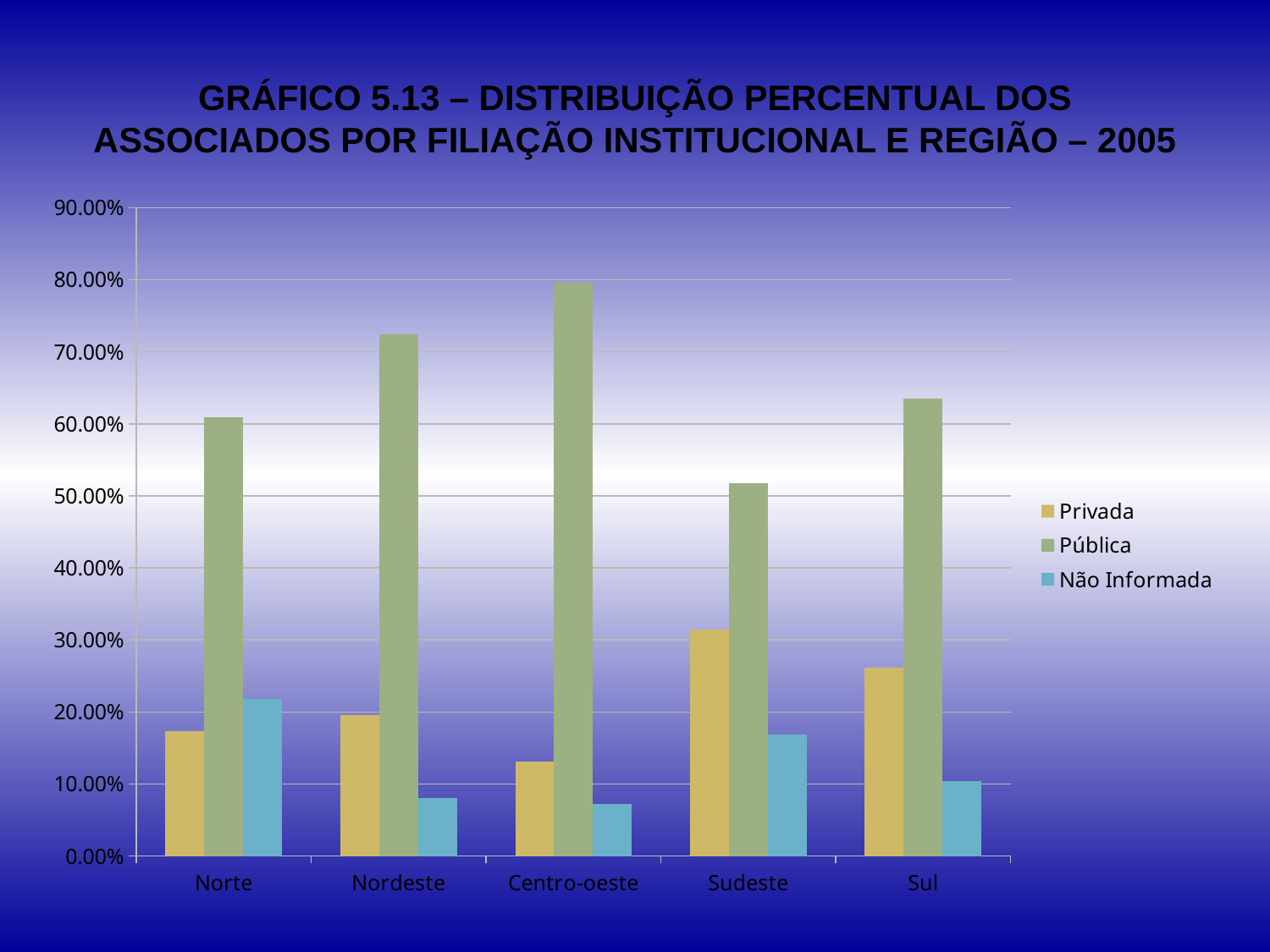
Is the value for Pública in Nordeste greater or less than 70.00%? greater How many regions are shown on the x axis? 5 Which region has the highest value for Pública? Centro-oeste How many series does the legend list? 3 Is the value for Não Informada in Nordeste greater or less than 10.00%? less In Norte, which is larger: Privada or Não Informada? Não Informada Which colour represents the Pública series in the legend? green What kind of chart is shown on the slide? bar chart Which region has the highest value for Não Informada? Norte Which region has the lowest value for Pública? Sudeste Which region has the highest value for Privada? Sudeste Which region has the lowest value for Privada? Centro-oeste